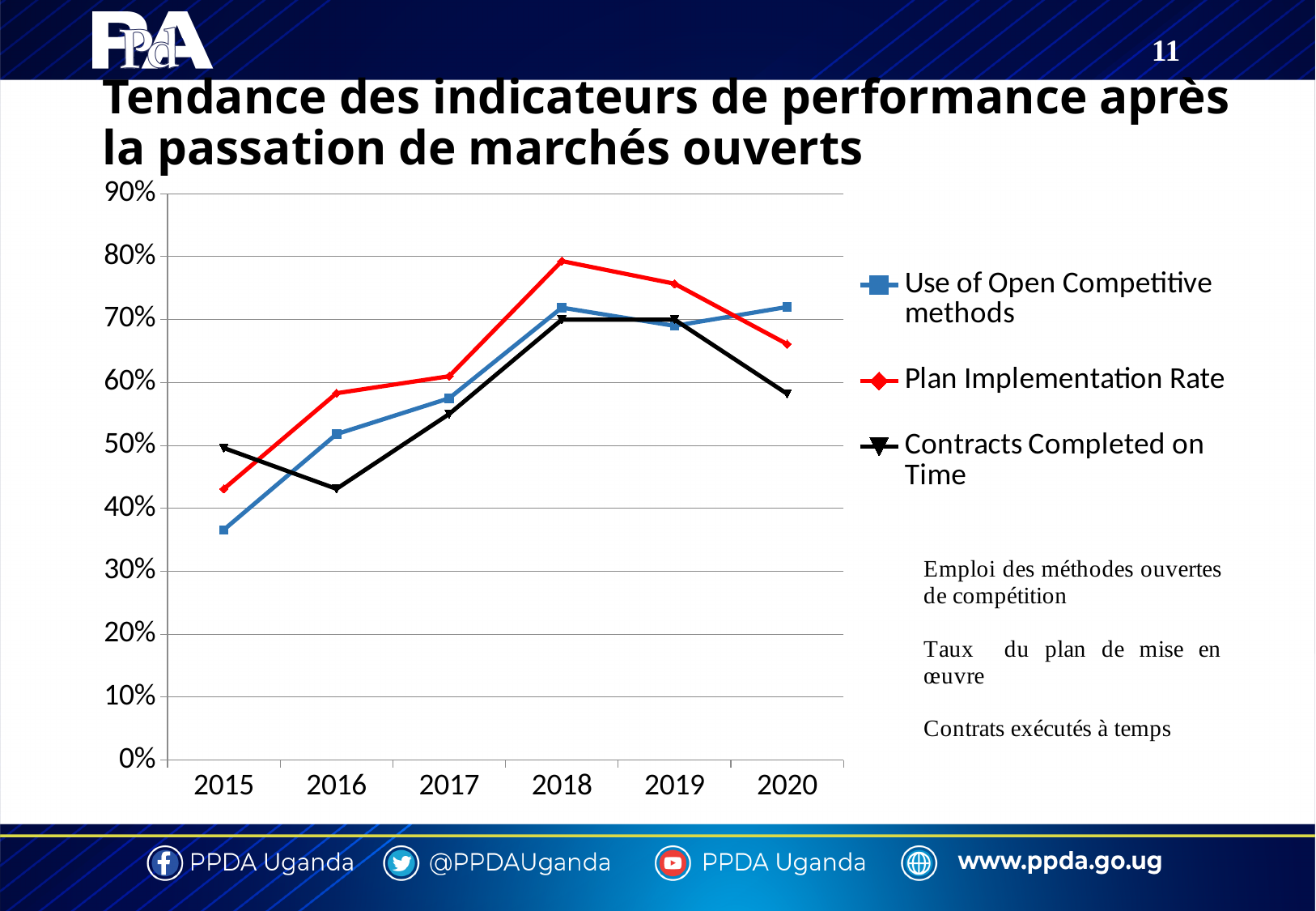
Is the value for Contracts Completed on Time in 2016 greater or less than 50%? less In which year is Contracts Completed on Time lowest? 2016 In which year is Use of Open Competitive methods lowest? 2015 In 2015, which is higher: Contracts Completed on Time or Use of Open Competitive methods? Contracts Completed on Time Does the Plan Implementation Rate rise or fall from 2018 to 2020? fall Is the Plan Implementation Rate in 2018 greater or less than 70%? greater How many series does the legend list? 3 How many years are shown on the x axis? 6 In 2020, which is higher: Plan Implementation Rate or Contracts Completed on Time? Plan Implementation Rate What kind of chart is shown on the slide? Line chart In which year is the Plan Implementation Rate highest? 2018 Is the value for Use of Open Competitive methods in 2015 greater or less than 40%? less